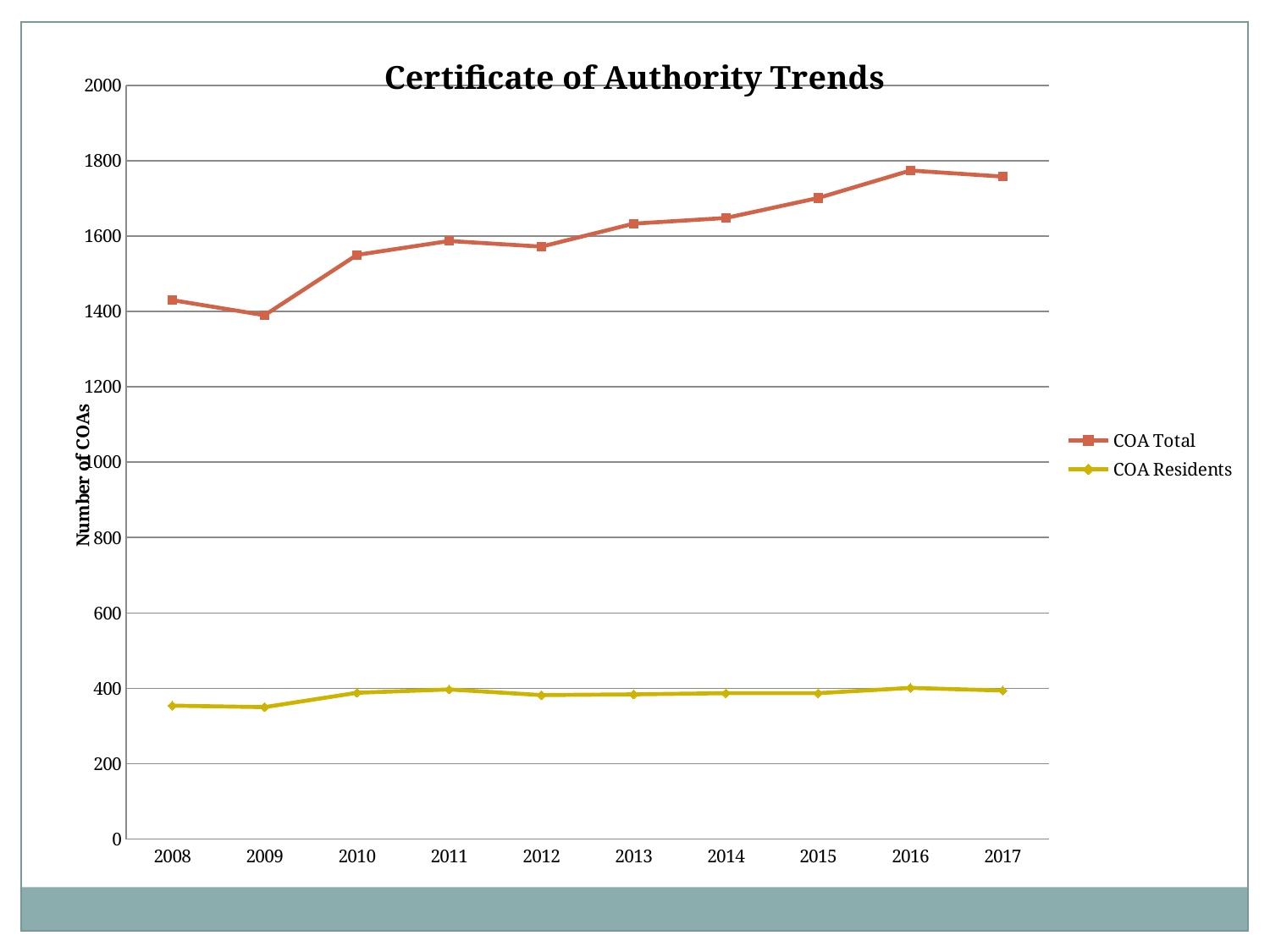
Does the COA Total series generally rise or fall from 2009 to 2016? rise Is the COA Total value for 2015 greater or less than 1600? greater How many series does the legend list? 2 In which year is the COA Total value lowest? 2009 How many years are plotted along the x axis? 10 What type of chart is shown on the slide? line chart In which year is the COA Total value highest? 2016 Which is larger in 2012, COA Total or COA Residents? COA Total Is the COA Total value for 2016 greater or less than 1800? less What is the title of the chart? Certificate of Authority Trends Is the COA Residents value for 2008 greater or less than 400? less